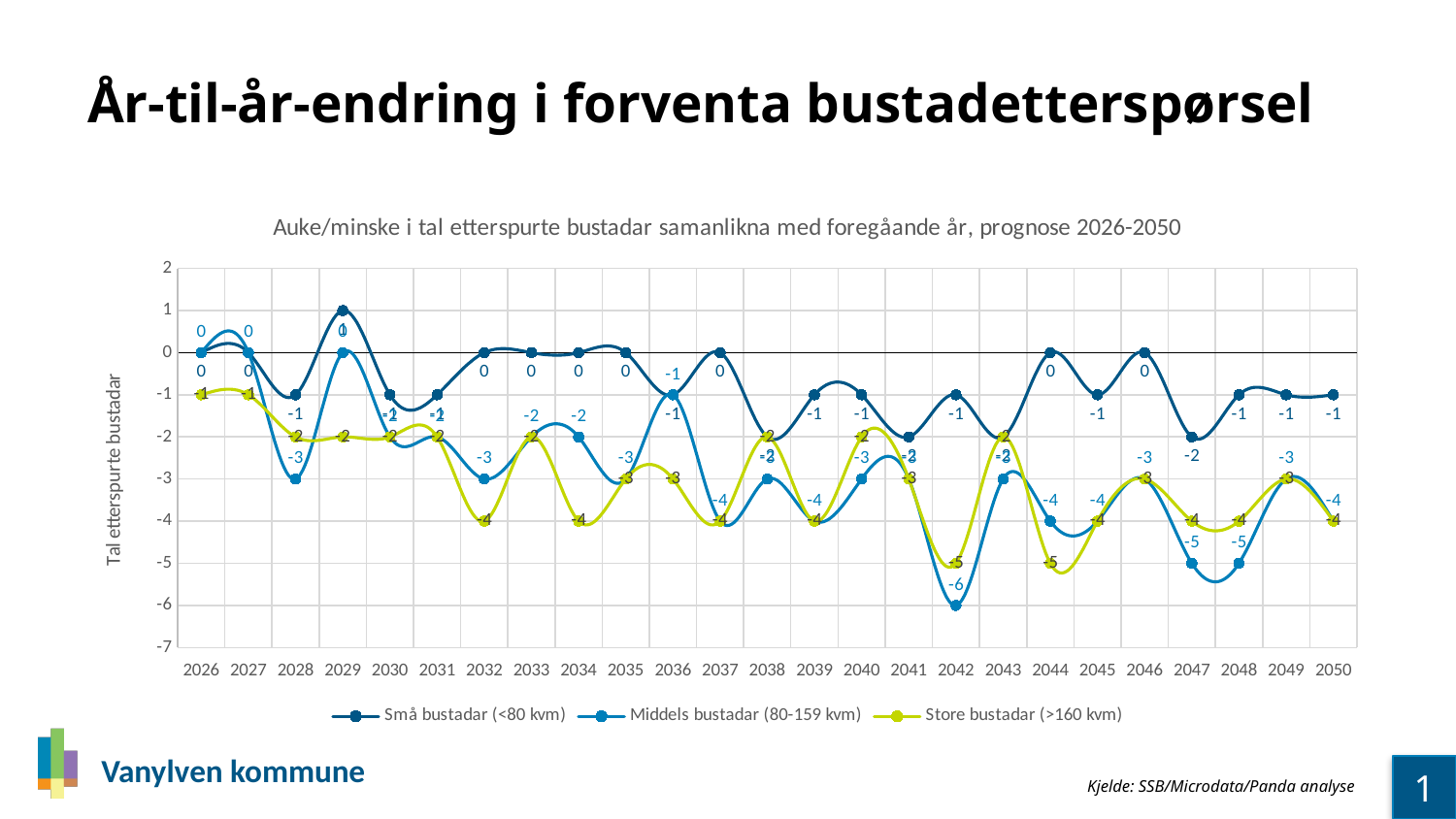
In 2047, which is larger: the value for Middels bustadar (80-159 kvm) or Store bustadar (>160 kvm)? Store bustadar (>160 kvm) How many years are plotted along the x axis? 25 In which year does Små bustadar (<80 kvm) reach its highest value? 2029 What is the value for Små bustadar (<80 kvm) in 2029? 1 What is the value for Middels bustadar (80-159 kvm) in 2042? -6 What is the difference between the Små bustadar (<80 kvm) value and the Middels bustadar (80-159 kvm) value in 2042? 5 What is the value for Store bustadar (>160 kvm) in 2044? -5 In which year does Middels bustadar (80-159 kvm) reach its lowest value? 2042 How many series does the legend list? 3 What is the subtitle printed above the chart? Auke/minske i tal etterspurte bustadar samanlikna med foregåande år, prognose 2026-2050 What is the value for Små bustadar (<80 kvm) in 2047? -2 What kind of chart is shown on the slide? line chart